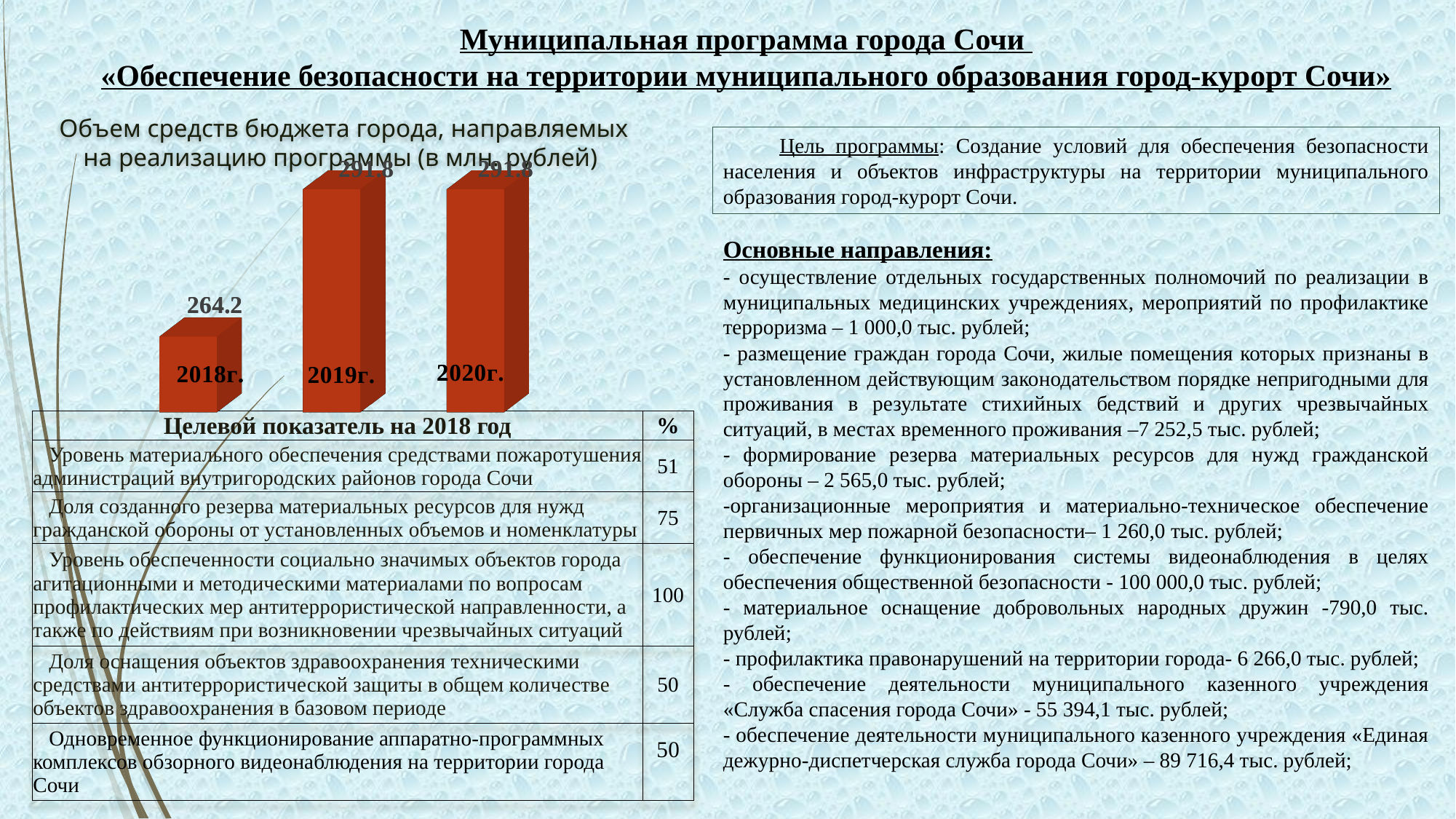
Does the value rise or fall from 2018г. to 2019г. in the bar chart? Rise Which year has the lowest value in the bar chart? 2018г. What colour are the bars in the chart? Red What is the difference between the values for 2020г. and 2018г. in the bar chart? 27.6 In what units are the values in the bar chart expressed, according to its title? млн. рублей How many bars (years) are shown in the bar chart? 3 Which is larger in the bar chart, the value for 2018г. or the value for 2019г.? 2019г. What is the value shown for 2018г. in the bar chart? 264.2 Which is larger in the bar chart, the value for 2018г. or the value for 2020г.? 2020г. What is the value shown for 2020г. in the bar chart? 291.8 What kind of chart is shown on the slide? Bar chart